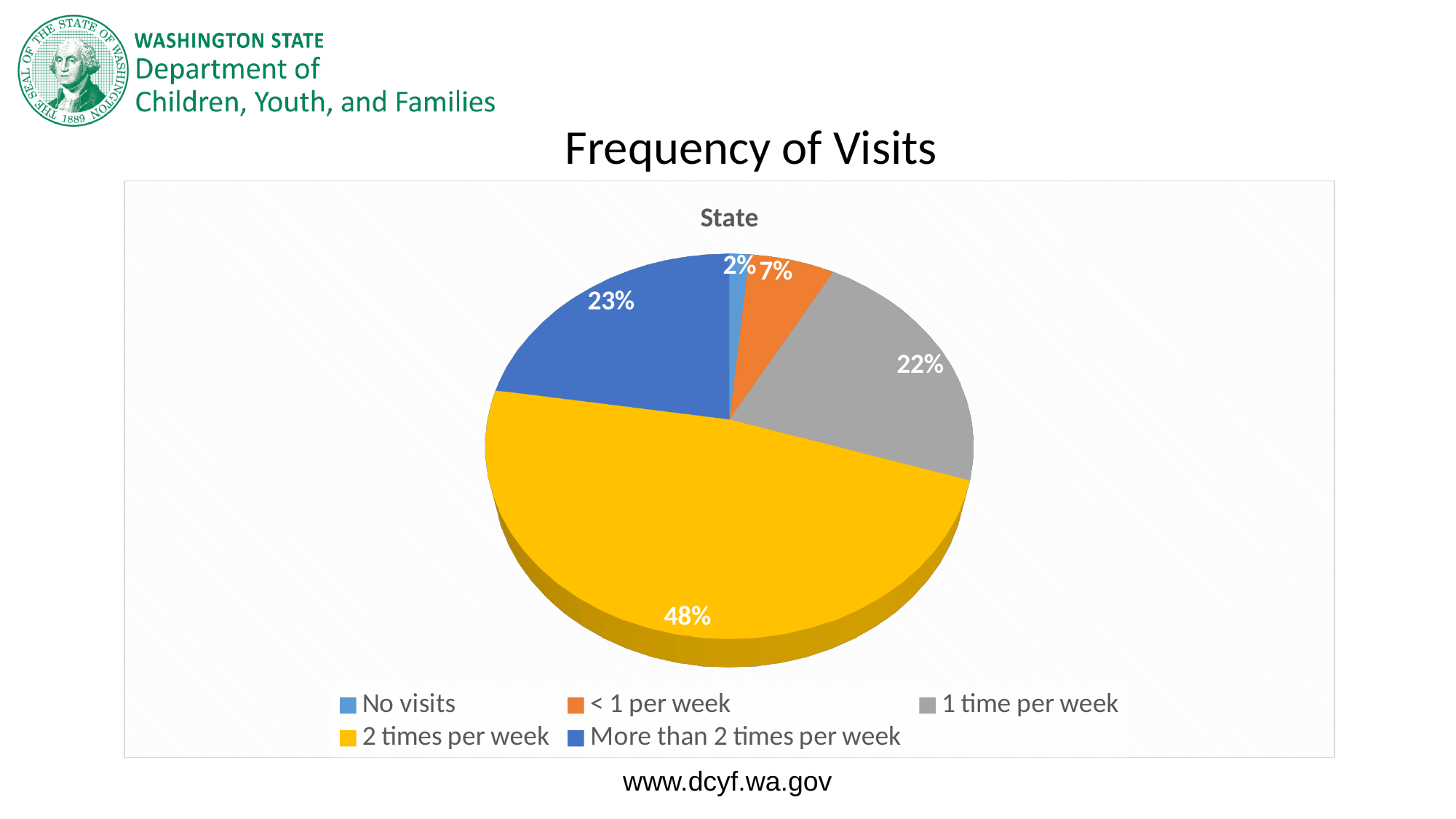
What share of the pie is labelled for 'More than 2 times per week'? 23% What is the difference in percentage points between '2 times per week' and 'More than 2 times per week'? 25 What is the title shown inside the chart area above the pie? State What share of the pie is labelled for '2 times per week'? 48% Which category has the smallest slice of the pie? No visits What share of the pie is labelled for '1 time per week'? 22% How many categories does the legend list? 5 Which category has the largest slice of the pie? 2 times per week What kind of chart is shown on the slide? Pie chart Which is larger, the slice for '< 1 per week' or the slice for '1 time per week'? 1 time per week